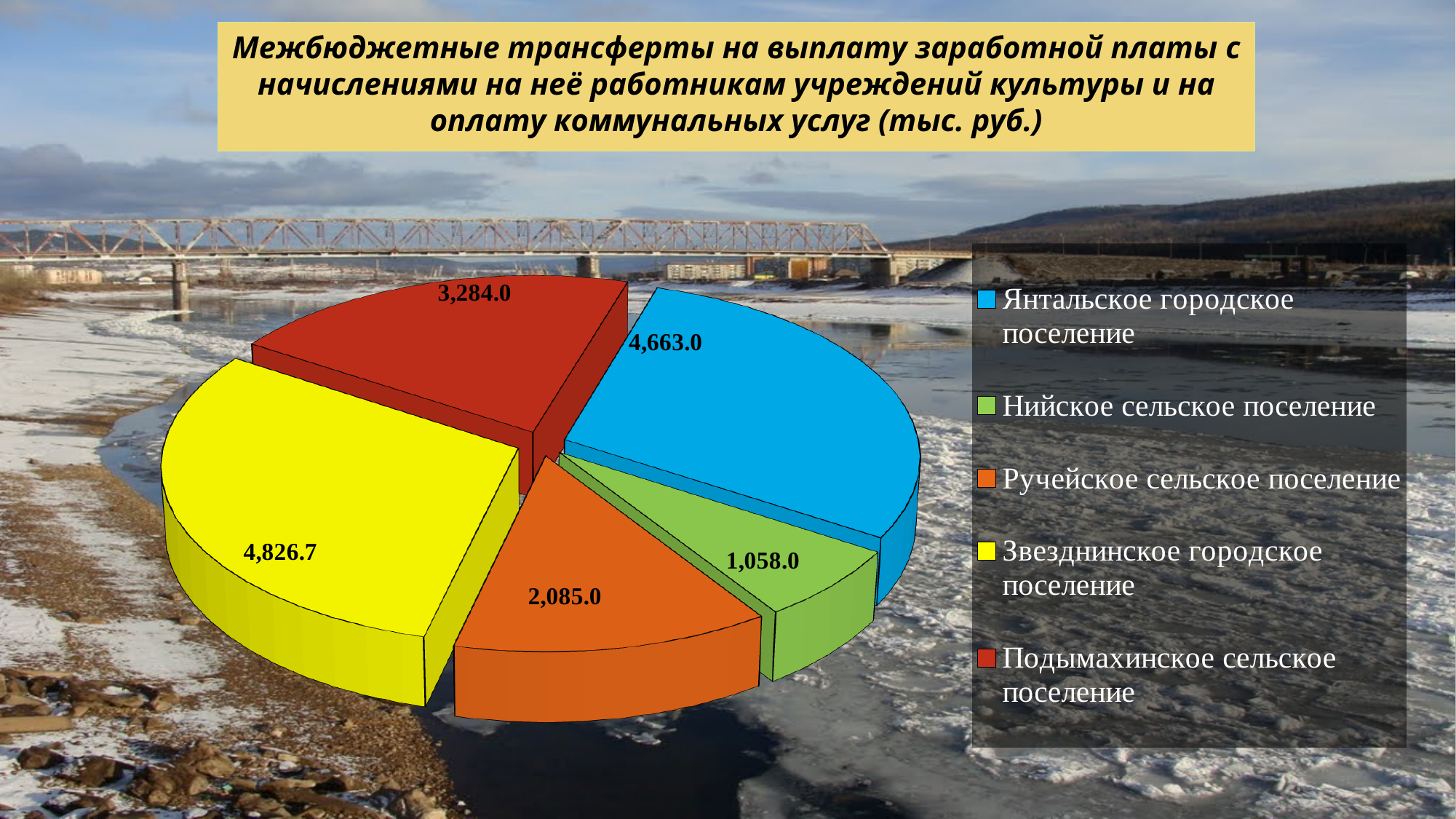
What is the difference between the values for Подымахинское сельское поселение and Ручейское сельское поселение? 1,199.0 What is the value for Янтальское городское поселение? 4,663.0 What is the value for Нийское сельское поселение? 1,058.0 What kind of chart is shown on the slide? Pie chart Which settlement has the smallest value in the pie chart? Нийское сельское поселение What is the value for Подымахинское сельское поселение? 3,284.0 Which is larger: the value for Подымахинское сельское поселение or Ручейское сельское поселение? Подымахинское сельское поселение What is the value for Ручейское сельское поселение? 2,085.0 What is the value for Звезднинское городское поселение? 4,826.7 What is the difference between the values for Звезднинское городское поселение and Янтальское городское поселение? 163.7 Which settlement has the largest value in the pie chart? Звезднинское городское поселение How many slices does the pie chart have? 5